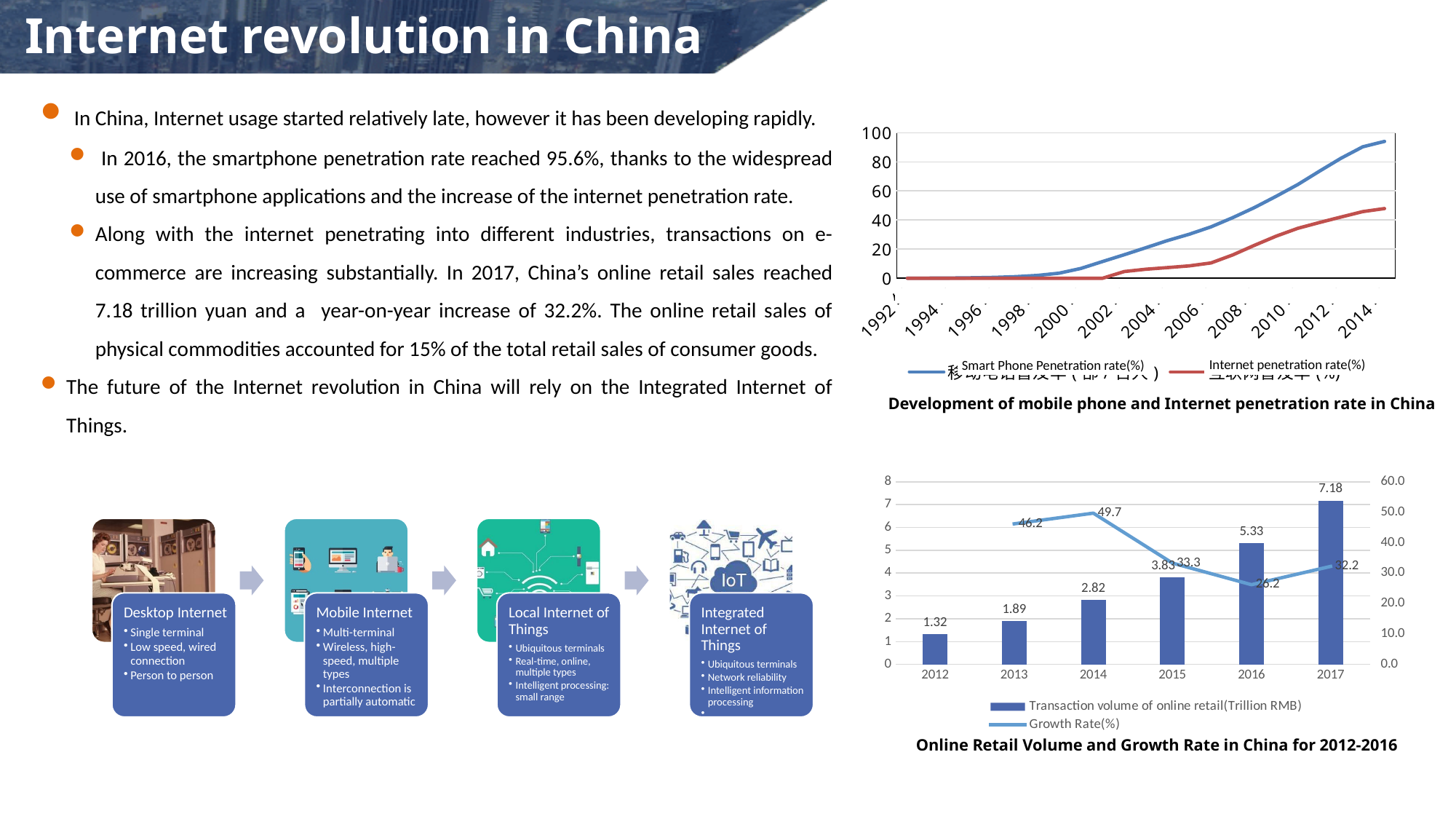
In the top chart 'Development of mobile phone and Internet penetration rate in China', is the Smart Phone Penetration rate in 2014 greater or less than 80? greater In the bottom chart 'Online Retail Volume and Growth Rate in China for 2012-2016', which year has the highest transaction volume of online retail? 2017 In the bottom chart 'Online Retail Volume and Growth Rate in China for 2012-2016', what is the difference between the transaction volume in 2017 and in 2016? 1.85 What kind of chart is the top chart titled 'Development of mobile phone and Internet penetration rate in China'? line chart In the bottom chart 'Online Retail Volume and Growth Rate in China for 2012-2016', does the transaction volume of online retail rise or fall from 2012 to 2017? rise How many series does the legend of the top chart 'Development of mobile phone and Internet penetration rate in China' list? 2 In the bottom chart 'Online Retail Volume and Growth Rate in China for 2012-2016', which year has the larger growth rate, 2013 or 2015? 2013 In the bottom chart 'Online Retail Volume and Growth Rate in China for 2012-2016', what is the growth rate in 2014? 49.7 In the top chart 'Development of mobile phone and Internet penetration rate in China', is the Internet penetration rate in 2014 greater or less than 60? less In the bottom chart 'Online Retail Volume and Growth Rate in China for 2012-2016', which year has the lowest labelled growth rate? 2016 How many years are shown on the x axis of the bottom chart 'Online Retail Volume and Growth Rate in China for 2012-2016'? 6 In the bottom chart 'Online Retail Volume and Growth Rate in China for 2012-2016', what is the transaction volume of online retail in 2017? 7.18